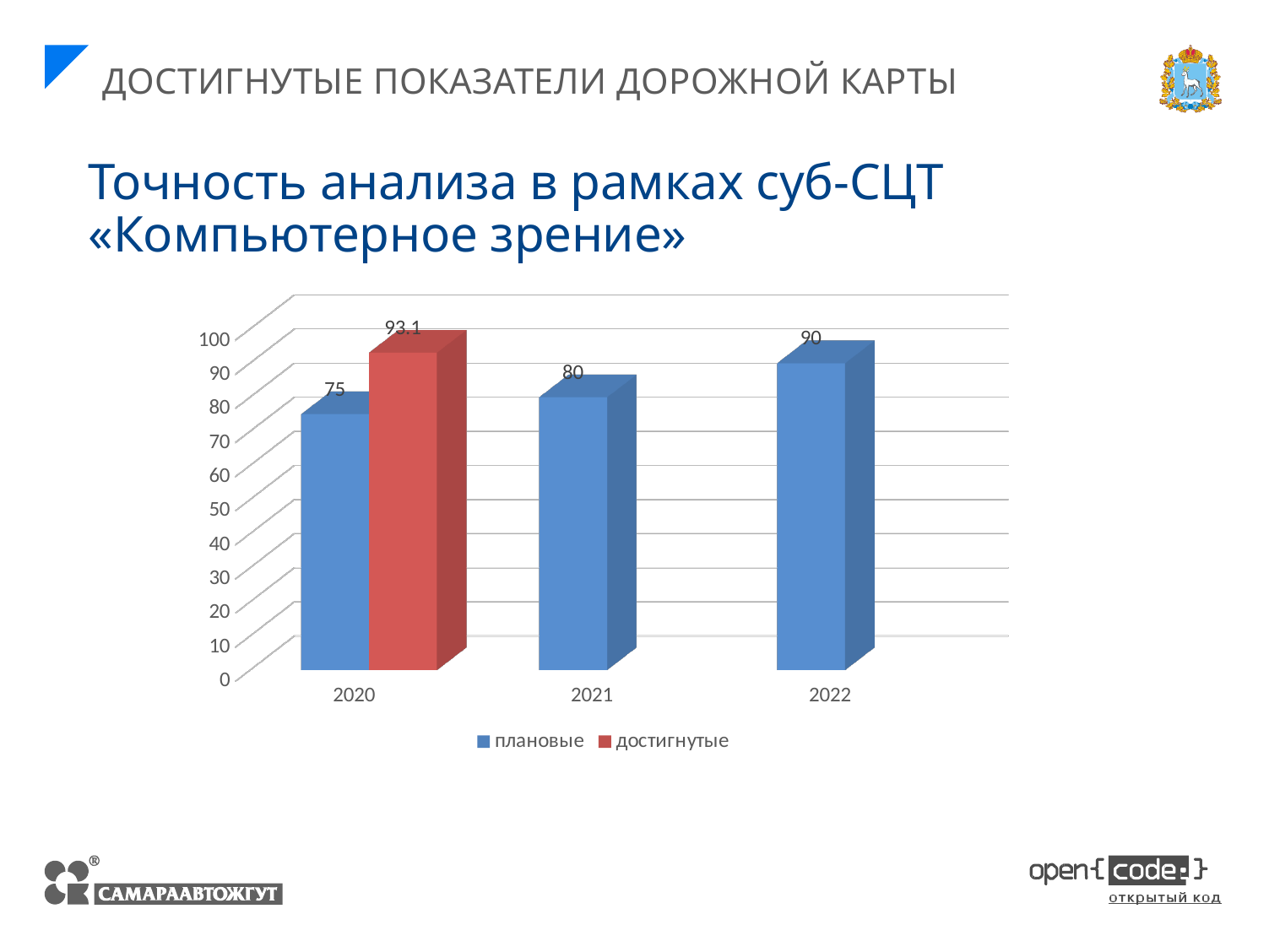
Which is larger for 2020: the planned value or the achieved value? достигнутые What is the planned (плановые) value for 2021? 80 What is the planned (плановые) value for 2022? 90 Which year has the highest planned (плановые) value? 2022 What is the achieved (достигнутые) value for 2020? 93.1 How many years are shown on the x axis? 3 What is the planned (плановые) value for 2020? 75 How many series does the legend list? 2 Which year has the lowest planned (плановые) value? 2020 What is the difference between the planned values for 2022 and 2021? 10 What is the difference between the achieved and planned values for 2020? 18.1 Do the planned (плановые) values rise or fall from 2020 to 2022? rise